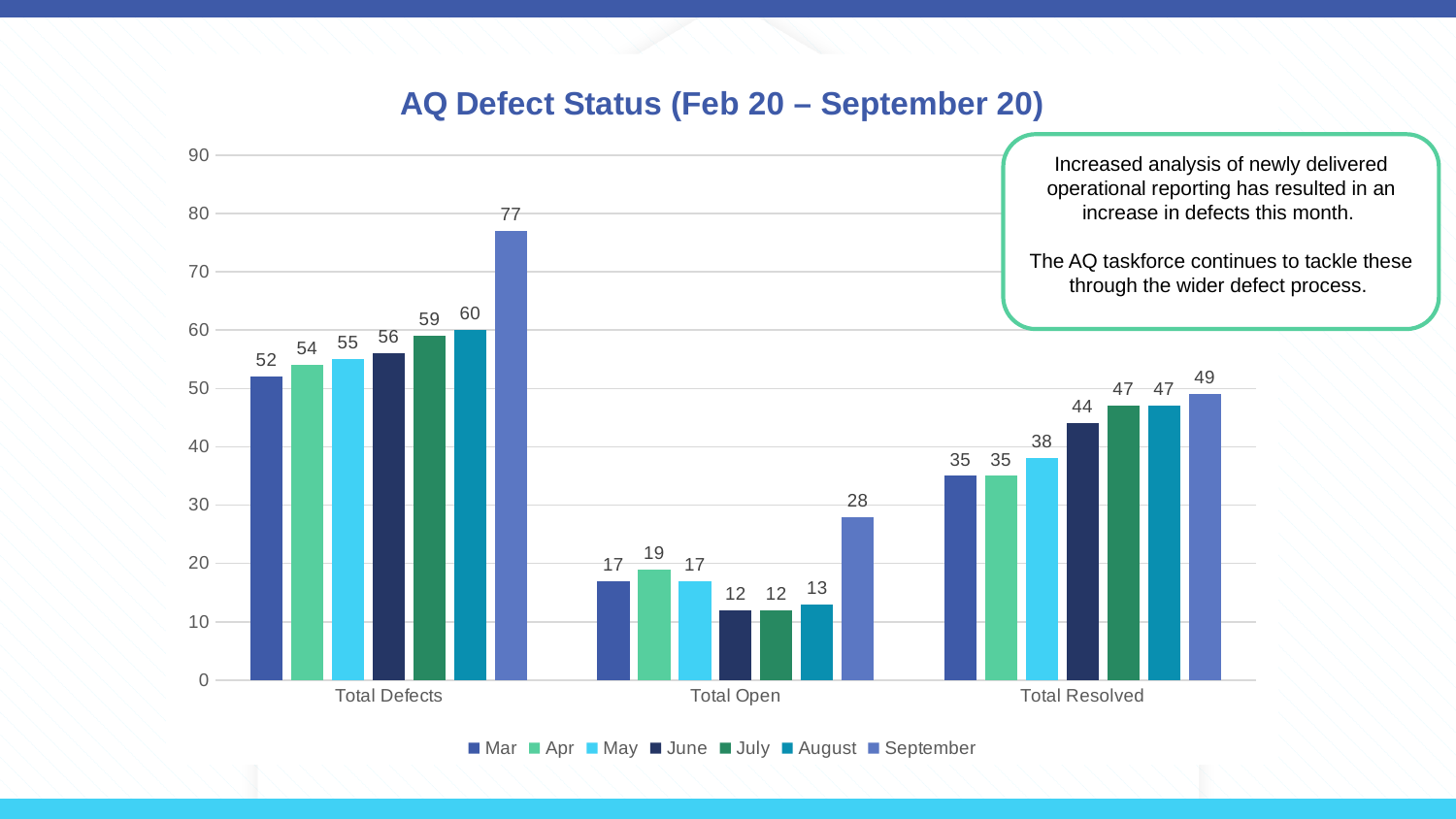
Which month has the lowest value in the Total Defects category? Mar What is the value for June in the Total Open category? 12 How many categories are shown on the x axis? 3 Which month has the highest value in the Total Resolved category? September What is the value for September in the Total Defects category? 77 What is the title of the chart? AQ Defect Status (Feb 20 – September 20) Is the value for September in the Total Open category greater or less than 20? greater What is the difference between the September and August values in the Total Defects category? 17 What is the value for May in the Total Resolved category? 38 What kind of chart is shown on the slide? Bar chart How many series does the legend list? 7 Which is larger in the Total Open category: the Apr value or the August value? Apr